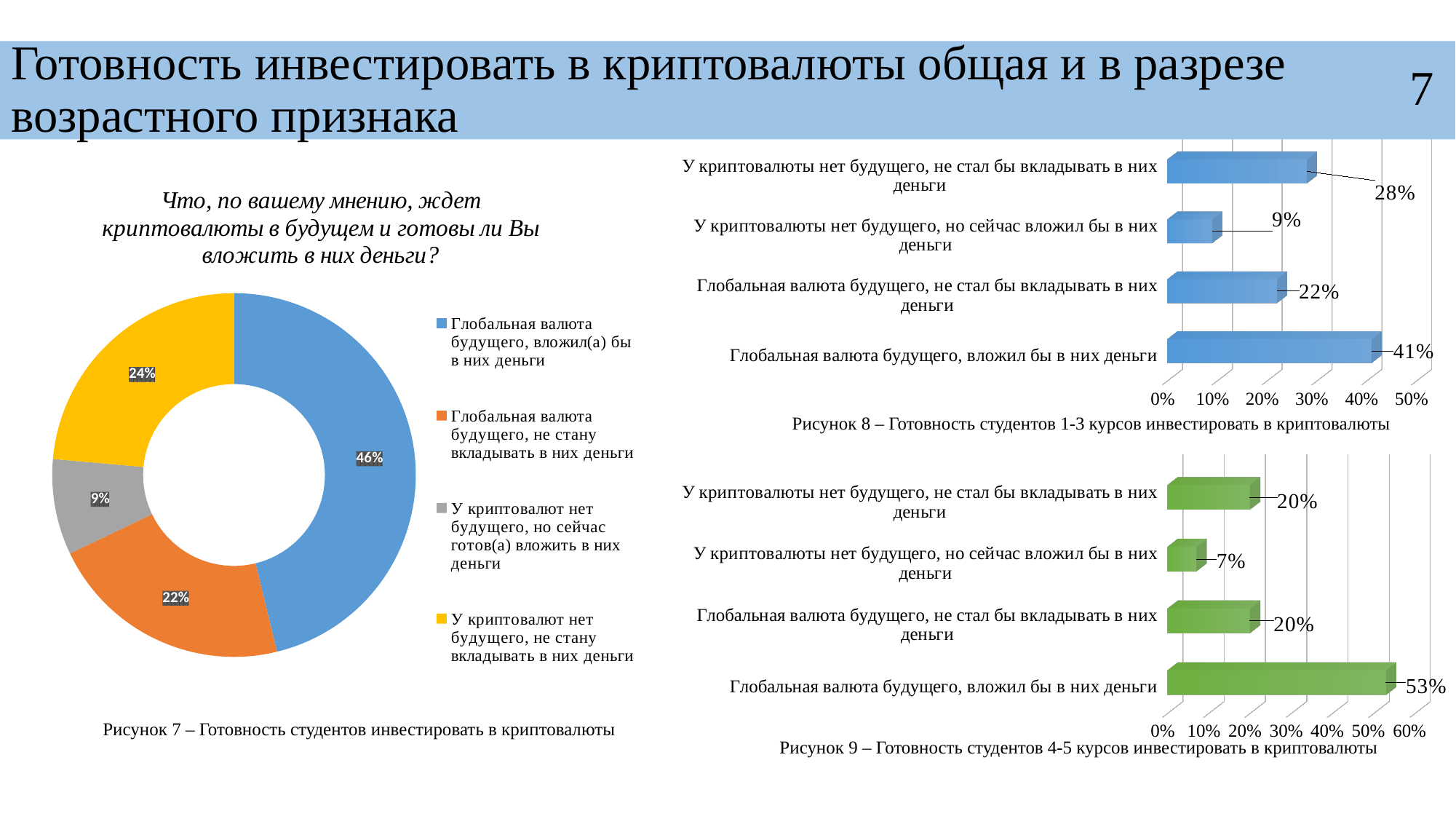
In the chart captioned 'Рисунок 7', which category has the smallest share? У криптовалют нет будущего, но сейчас готов(а) вложить в них деньги What kind of chart is 'Рисунок 8 – Готовность студентов 1-3 курсов инвестировать в криптовалюты'? Bar chart Which is larger: the value for 'Глобальная валюта будущего, вложил бы в них деньги' in the chart captioned 'Рисунок 8' or in the chart captioned 'Рисунок 9'? Рисунок 9 (53%) In the chart captioned 'Рисунок 9 – Готовность студентов 4-5 курсов инвестировать в криптовалюты', what is the value for 'Глобальная валюта будущего, вложил бы в них деньги'? 53% In the chart captioned 'Рисунок 8', what is the difference between the values for 'Глобальная валюта будущего, вложил бы в них деньги' and 'У криптовалюты нет будущего, не стал бы вкладывать в них деньги'? 13% In the chart captioned 'Рисунок 7 – Готовность студентов инвестировать в криптовалюты', what share is shown for 'Глобальная валюта будущего, вложил(а) бы в них деньги'? 46% In the chart captioned 'Рисунок 8 – Готовность студентов 1-3 курсов инвестировать в криптовалюты', what is the value for 'Глобальная валюта будущего, вложил бы в них деньги'? 41% What colour are the bars in the chart captioned 'Рисунок 9 – Готовность студентов 4-5 курсов инвестировать в криптовалюты'? Green How many categories does the legend of the chart captioned 'Рисунок 7' list? 4 What kind of chart is 'Рисунок 7 – Готовность студентов инвестировать в криптовалюты'? Doughnut (pie) chart In the chart captioned 'Рисунок 9', which category has the lowest value? У криптовалюты нет будущего, но сейчас вложил бы в них деньги In the chart captioned 'Рисунок 8', what is the value for 'У криптовалюты нет будущего, но сейчас вложил бы в них деньги'? 9%